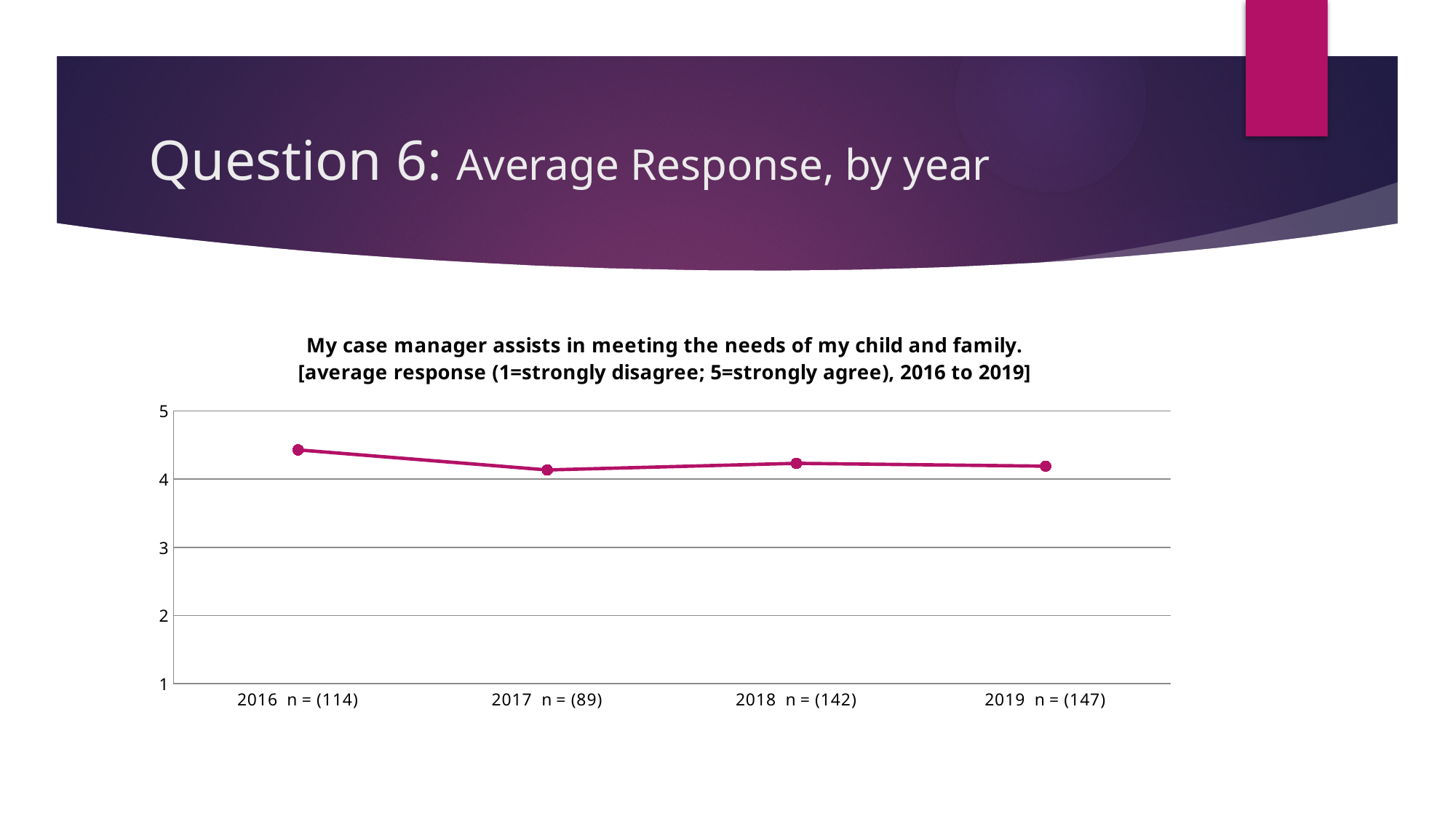
What is the sample size (n) shown for 2019 on the x axis? 147 Is the average response for 2017 greater or less than 4? greater Which is larger, the average response for 2016 or for 2019? 2016 What kind of chart is shown on the slide? line chart Does the average response rise or fall from 2016 to 2017? fall Which is larger, the average response for 2016 or for 2017? 2016 Which year has the highest average response? 2016 Is the average response for 2016 greater or less than 4? greater Does the average response rise or fall from 2017 to 2018? rise What survey statement is the chart about, according to its title? My case manager assists in meeting the needs of my child and family. Is the average response for 2019 greater or less than 5? less How many years (data points) are plotted on the chart? 4